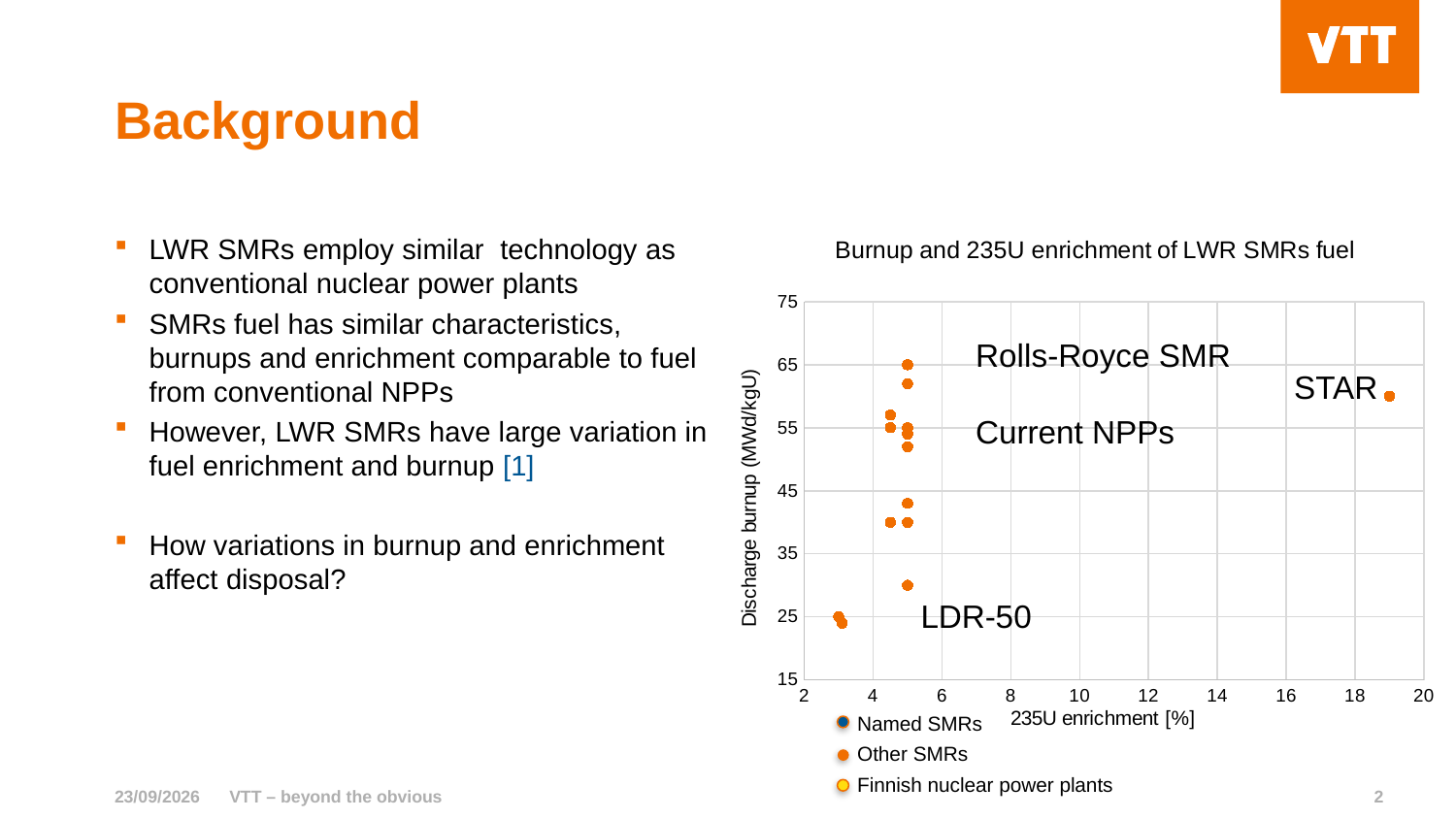
Is the 235U enrichment for LDR-50 greater or less than 6? less Which labelled reactor has the highest 235U enrichment in the chart? STAR Is the discharge burnup for STAR greater or less than 45? greater What is the label of the y axis of the chart? Discharge burnup (MWd/kgU) Which has the larger discharge burnup, Rolls-Royce SMR or LDR-50? Rolls-Royce SMR Is the discharge burnup for LDR-50 greater or less than 35? less How many series does the chart legend list? 3 Which has the larger 235U enrichment, STAR or LDR-50? STAR What is the title of the chart? Burnup and 235U enrichment of LWR SMRs fuel Which labelled reactor has the lowest discharge burnup in the chart? LDR-50 What kind of chart is shown on the slide? Scatter chart